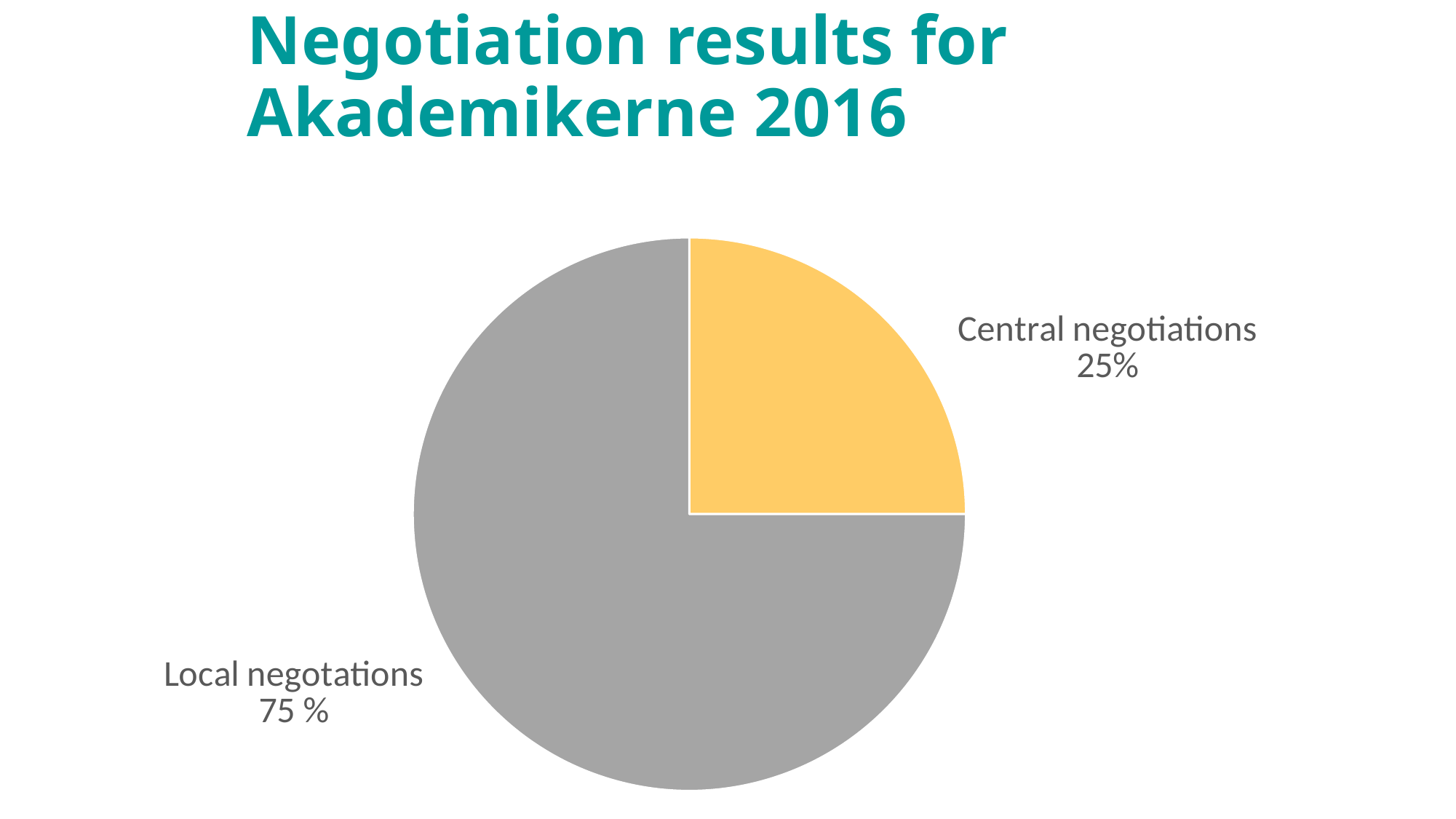
What colour is the Central negotiations slice? yellow What is the title of the slide? Negotiation results for Akademikerne 2016 What kind of chart is shown on the slide? pie chart What share of the pie is Local negotations? 75 % What is the difference in percentage points between Local negotations and Central negotiations? 50 How many slices does the pie chart have? 2 Which slice is the largest? Local negotations Which is larger, Central negotiations or Local negotations? Local negotations What share of the pie is Central negotiations? 25% Which slice is the smallest? Central negotiations